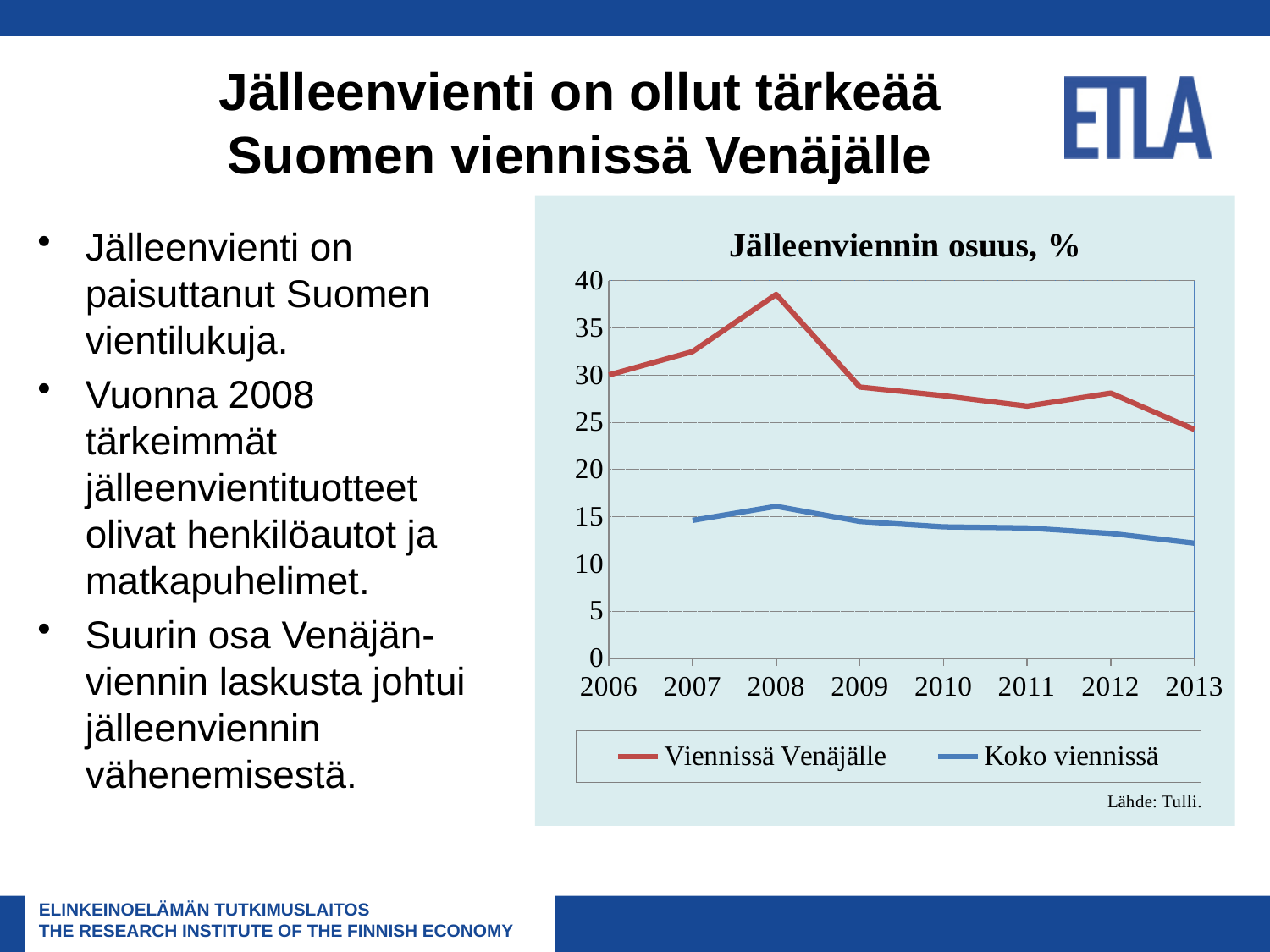
What is the title of the chart? Jälleenviennin osuus, % What kind of chart is shown on the slide? Line chart In which year does the Koko viennissä series reach its highest value? 2008 Is the value for Viennissä Venäjälle in 2009 greater or less than 30? less Is the value for Viennissä Venäjälle in 2008 greater or less than 35? greater Is the value for Koko viennissä in 2013 greater or less than 15? less How many years are shown on the x axis of the chart? 8 In which year does the Viennissä Venäjälle series reach its highest value? 2008 Does the Viennissä Venäjälle series rise or fall from 2008 to 2013? Fall Which series has the larger value in 2008, Viennissä Venäjälle or Koko viennissä? Viennissä Venäjälle In which year does the Viennissä Venäjälle series reach its lowest value? 2013 How many series does the legend of the chart list? 2